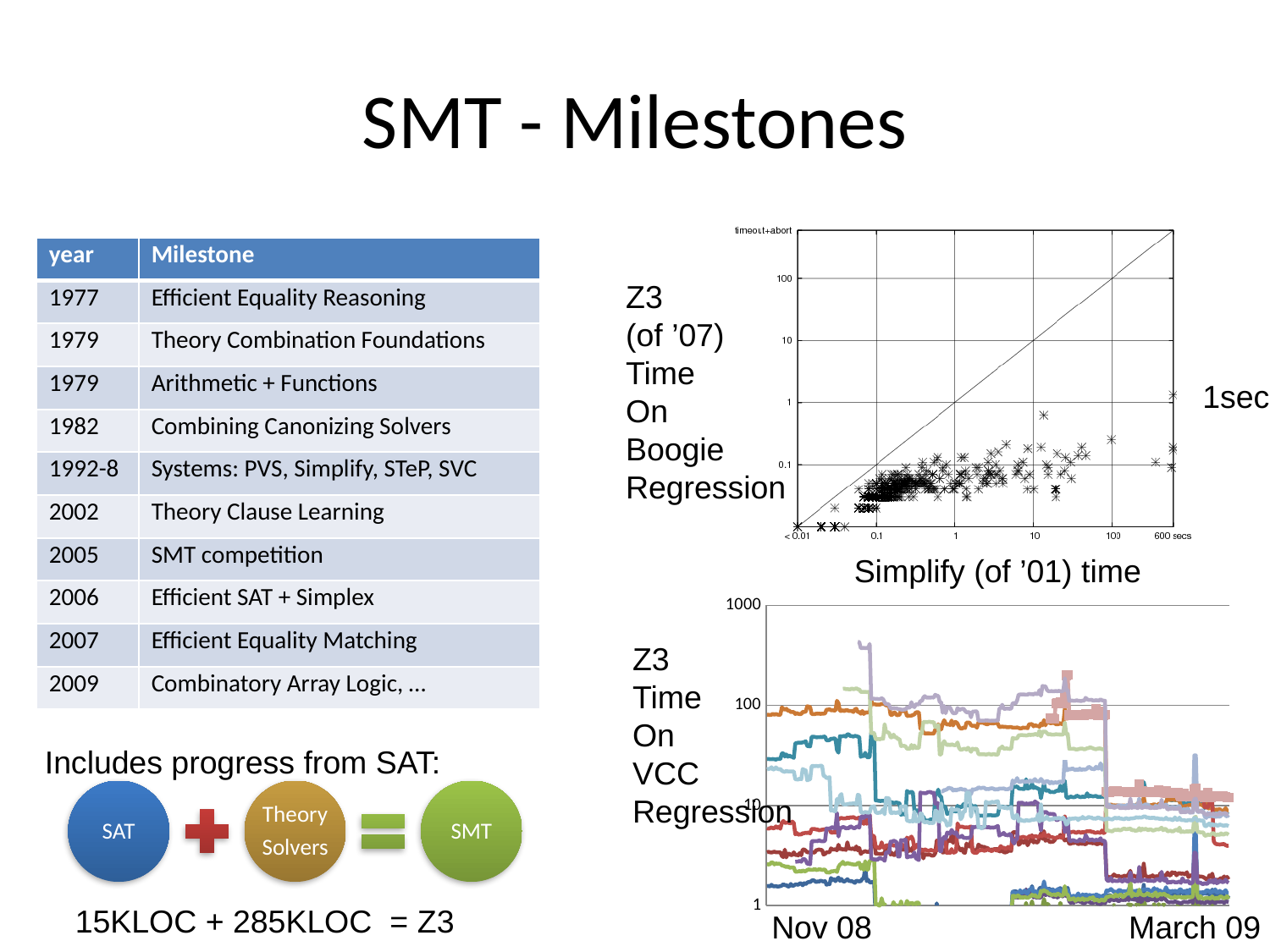
In the lower line chart, what are the two dates labelled at the ends of the horizontal axis? Nov 08 and March 09 What kind of chart is the lower chart on the right of the slide (Z3 time on VCC regression)? line chart In the lower line chart, what is the lowest value labelled on the vertical axis? 1 In the upper scatter chart, do most of the plotted points lie above or below the diagonal line? below In the upper scatter chart, what is the label at the top of the vertical axis? timeout+abort In the lower line chart, what is the highest value labelled on the vertical axis? 1000 What kind of chart is the upper chart on the right of the slide (Z3 of '07 time on Boogie regression)? scatter plot In the upper scatter chart, what quantity is plotted on the horizontal axis? Simplify (of '01) time In the upper scatter chart, what is the largest time value labelled on the horizontal axis? 600 secs